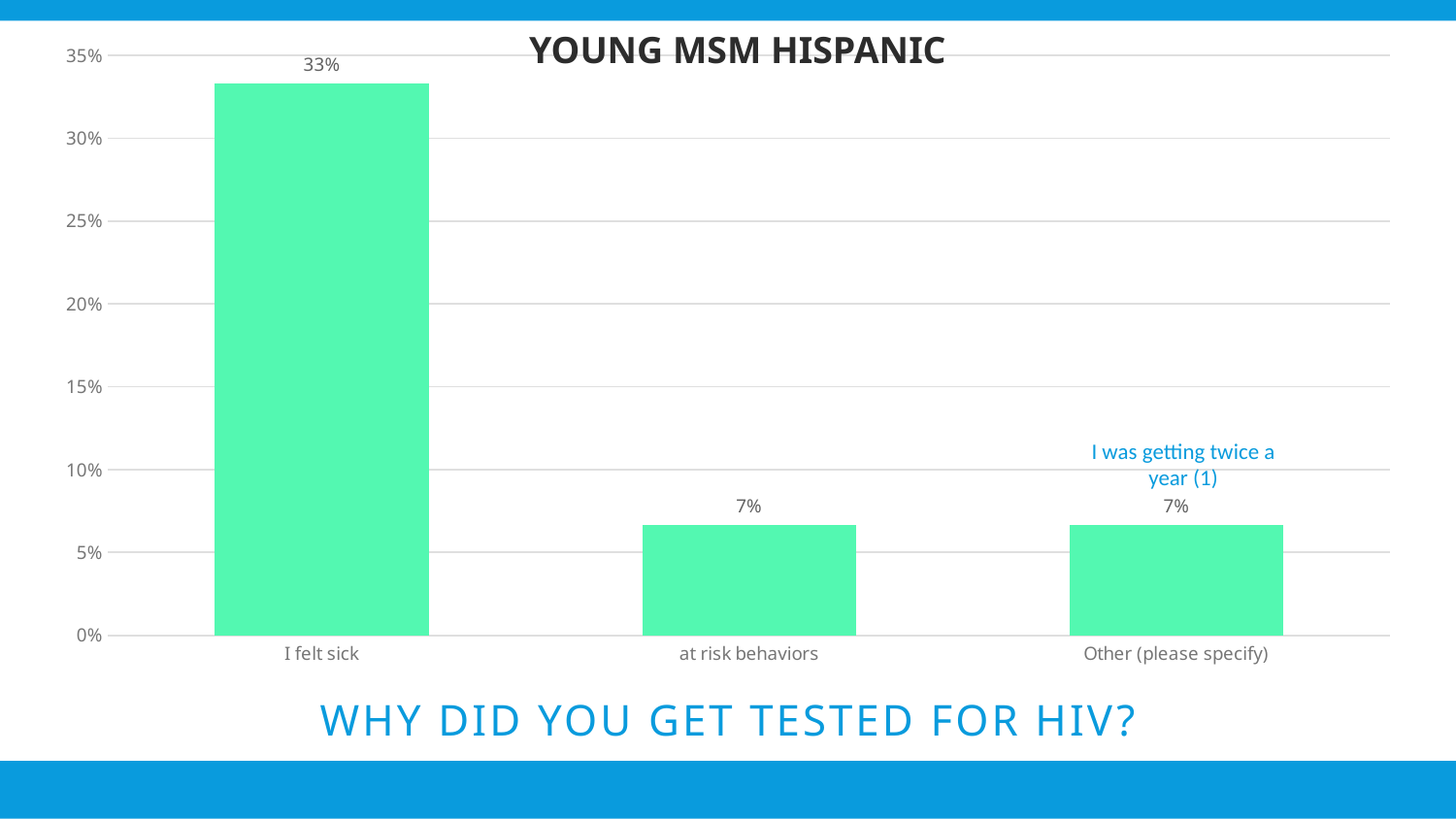
Which is larger, the value for "I felt sick" or the value for "Other (please specify)"? I felt sick What is the value for "I felt sick"? 33% What is the difference between the values for "I felt sick" and "at risk behaviors"? 26% Is the value for "at risk behaviors" greater or less than 10%? less How many categories are shown on the x axis? 3 What is the value for "at risk behaviors"? 7% What is the title of the chart? YOUNG MSM HISPANIC What kind of chart is shown on the slide? bar chart Which category has the highest value? I felt sick Is the value for "I felt sick" greater or less than 30%? greater What is the value for "Other (please specify)"? 7% What text annotation appears above the "Other (please specify)" bar? I was getting twice a year (1)